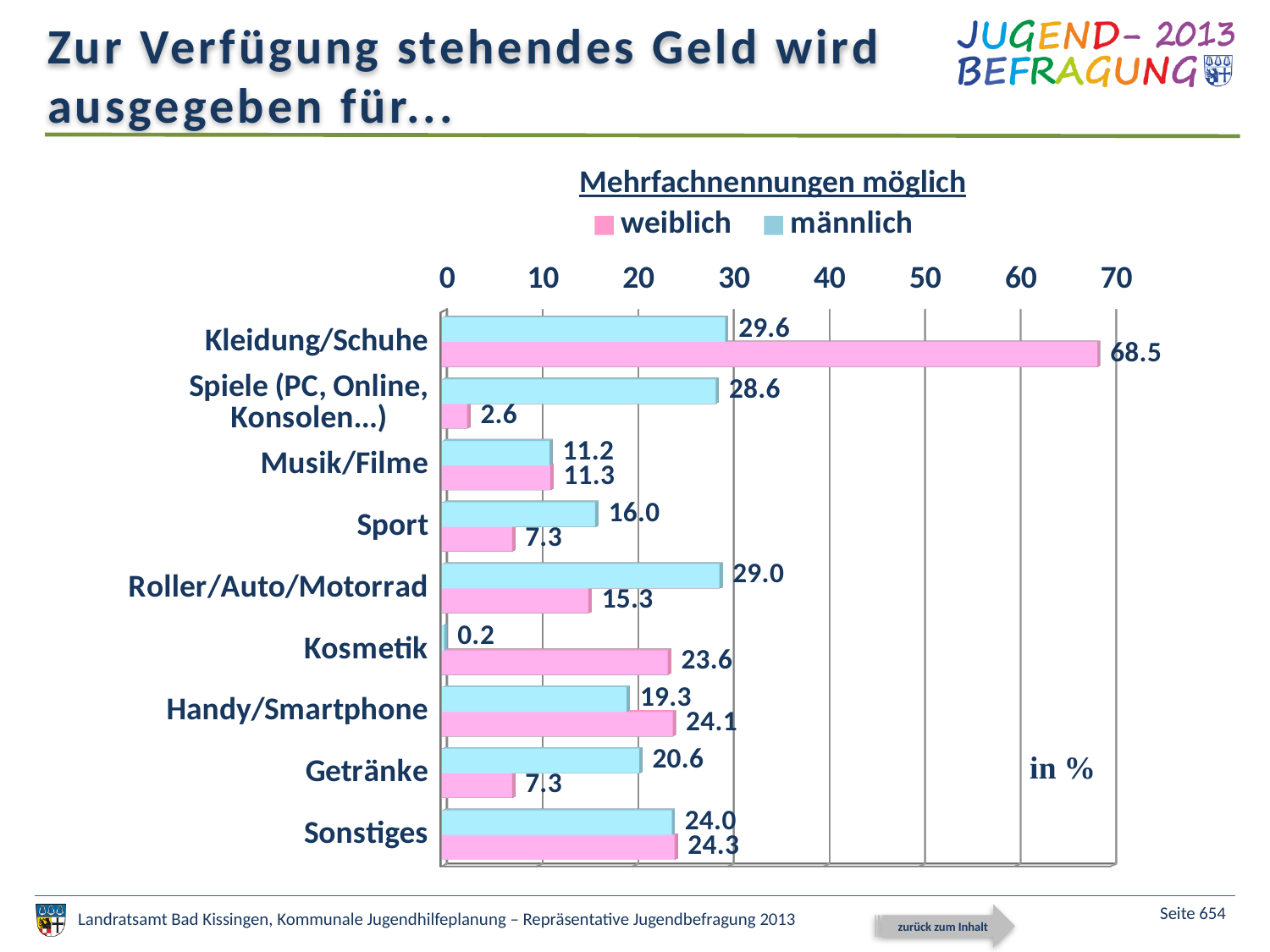
Which category has the highest weiblich value? Kleidung/Schuhe What is the difference between the weiblich and männlich values for Kleidung/Schuhe? 38.9 Which category has the lowest männlich value? Kosmetik What kind of chart is shown on the slide? bar chart How many series does the legend list? 2 Is the weiblich value for Kleidung/Schuhe greater or less than 60? greater What is the männlich value for Kosmetik? 0.2 Which colour represents the weiblich series in the legend? pink Which is larger for Spiele (PC, Online, Konsolen...): the weiblich value or the männlich value? männlich What is the männlich value for Roller/Auto/Motorrad? 29.0 What is the weiblich value for Kleidung/Schuhe? 68.5 How many categories are shown on the chart? 9